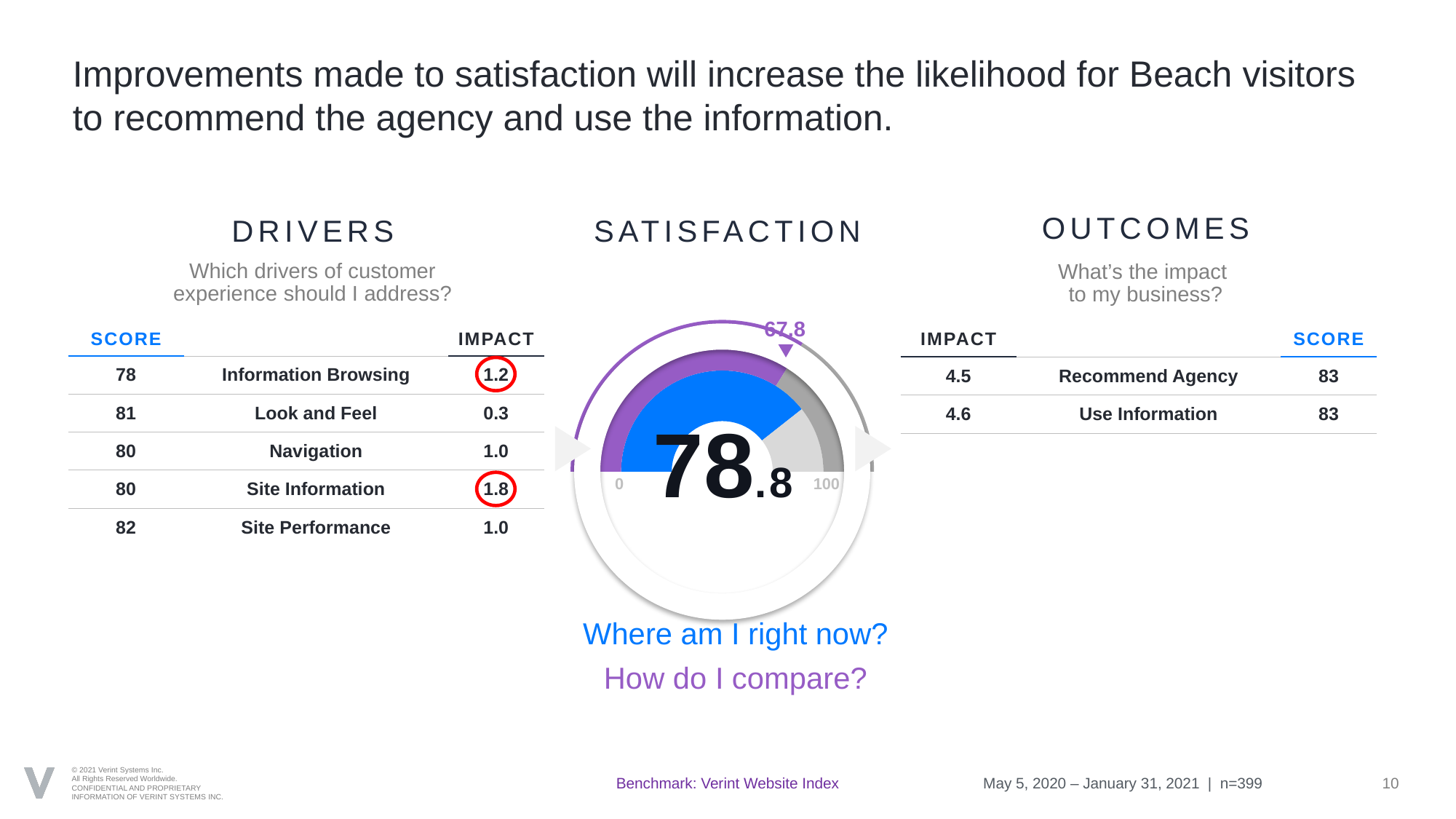
By how much does the satisfaction score on the gauge exceed the benchmark value? 11.0 In the Drivers table, which driver has the lowest impact value? Look and Feel What is the satisfaction score shown in the centre of the gauge? 78.8 Is the satisfaction score on the gauge greater or less than 100? less What benchmark is the gauge compared against, according to the footer? Verint Website Index In the Outcomes table, what is the impact value for Use Information? 4.6 What are the minimum and maximum values shown on the gauge scale? 0 and 100 What kind of chart is shown in the Satisfaction section? gauge chart What benchmark value is marked on the gauge? 67.8 Is the satisfaction score on the gauge greater or less than the benchmark value? greater In the Drivers table, which driver has the highest impact value? Site Information In the Drivers table, what is the score for Site Performance? 82